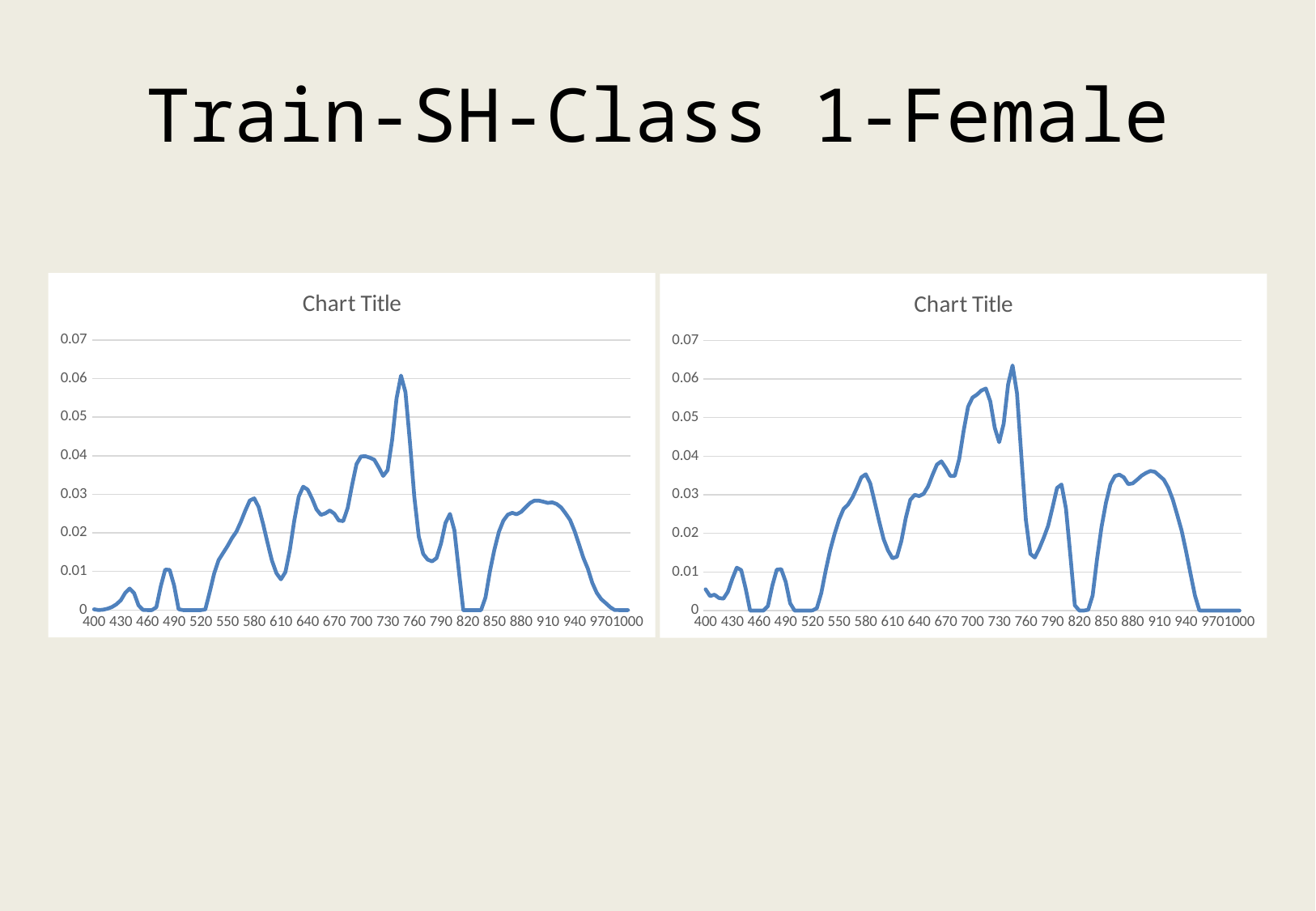
In the right chart, is the value at 400 greater or less than 0.01? less What kind of chart is the left chart? line chart How many charts are shown on the slide? 2 In the right chart, which is larger, the value at 700 or the value at 880? 700 In the left chart, is the highest value of the line greater or less than 0.05? greater In the right chart, is the value at 880 greater or less than 0.03? greater In the left chart, does the line rise or fall between 910 and 1000? fall In the right chart, does the line rise or fall between 820 and 880? rise What kind of chart is the right chart? line chart What is the title shown on the left chart? Chart Title